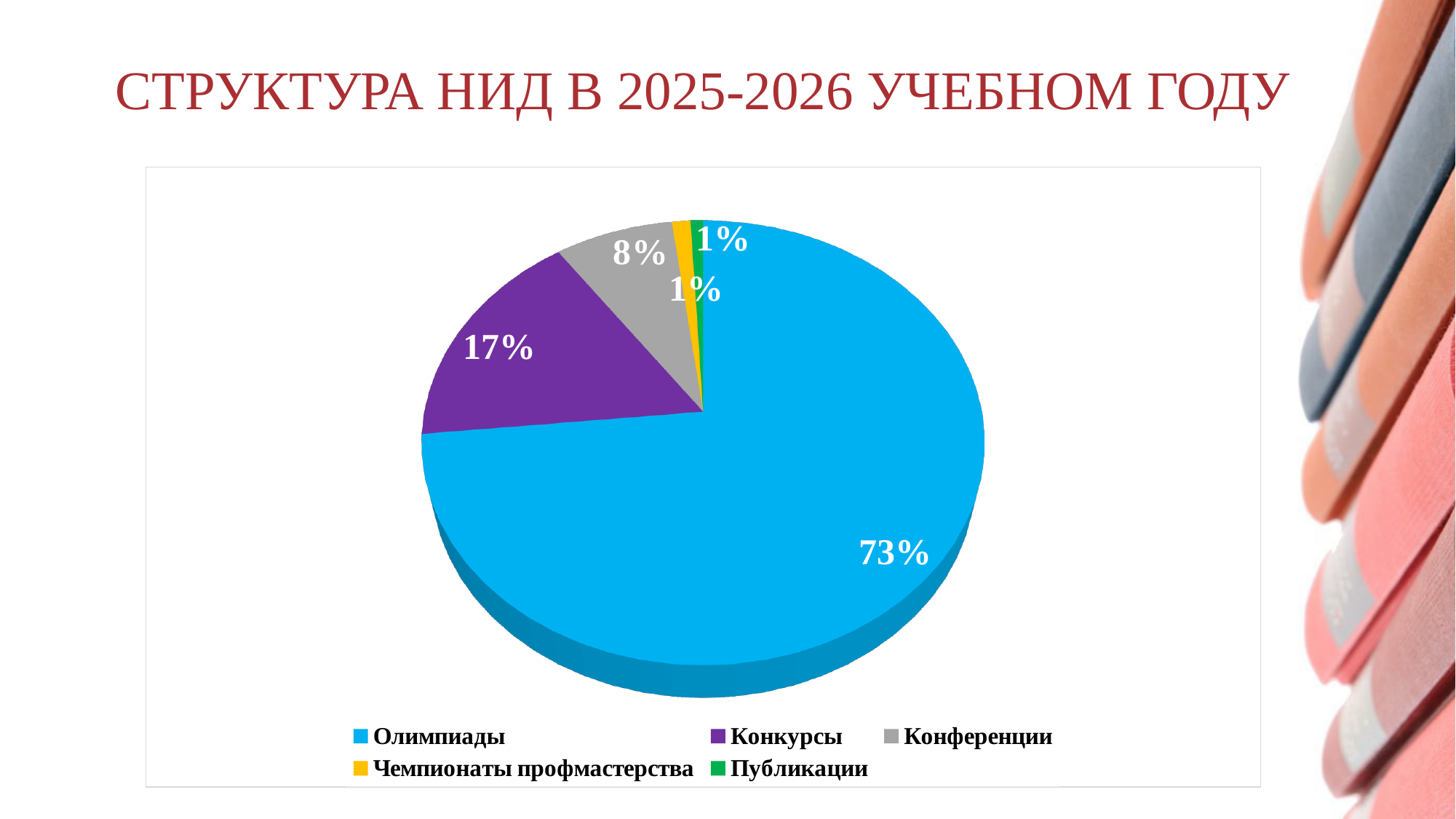
What is the difference between the shares of Олимпиады and Конкурсы? 56% Which is larger, the share for Конкурсы or the share for Конференции? Конкурсы What is the value shown for Чемпионаты профмастерства? 1% What colour is the Конкурсы slice in the pie chart? Purple What share of the pie does Олимпиады have? 73% What is the value shown for Конференции? 8% How many categories does the pie chart have? 5 What is the value shown for Публикации? 1% What is the value shown for Конкурсы? 17% What kind of chart is shown on the slide? Pie chart What is the title of the slide containing the pie chart? СТРУКТУРА НИД В 2025-2026 УЧЕБНОМ ГОДУ Which category has the largest share of the pie? Олимпиады